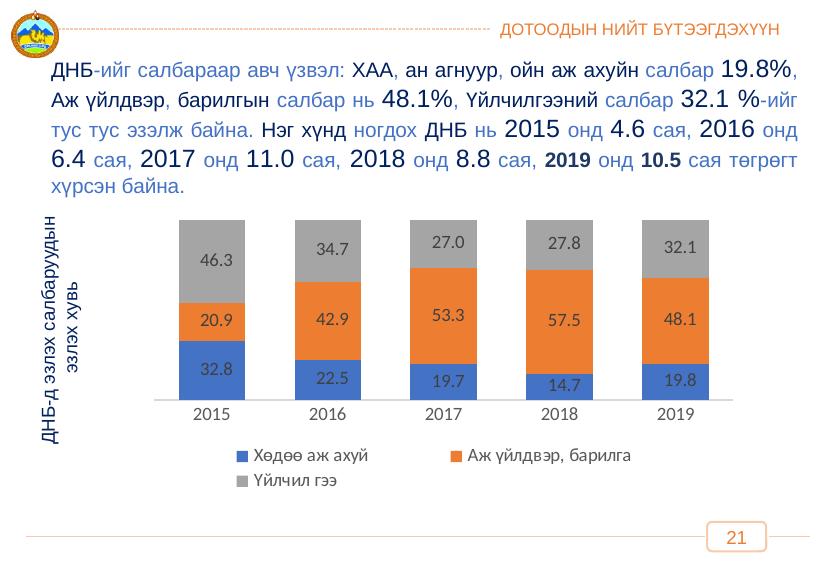
In which year is the Аж үйлдвэр, барилга value highest? 2018 What is the difference between the Үйлчилгээ values for 2015 and 2016? 11.6 Which series is shown in orange in the legend? Аж үйлдвэр, барилга In which year is the Хөдөө аж ахуй value lowest? 2018 What is the value for Аж үйлдвэр, барилга in 2018? 57.5 What kind of chart is shown on the slide? Stacked bar chart How many years are shown on the x axis? 5 What is the value for Хөдөө аж ахуй in 2015? 32.8 What is the total of the stacked bar for 2017? 100.0 How many series does the legend list? 3 What is the value for Үйлчилгээ in 2019? 32.1 Which is larger, the Хөдөө аж ахуй value in 2016 or in 2019? 2016